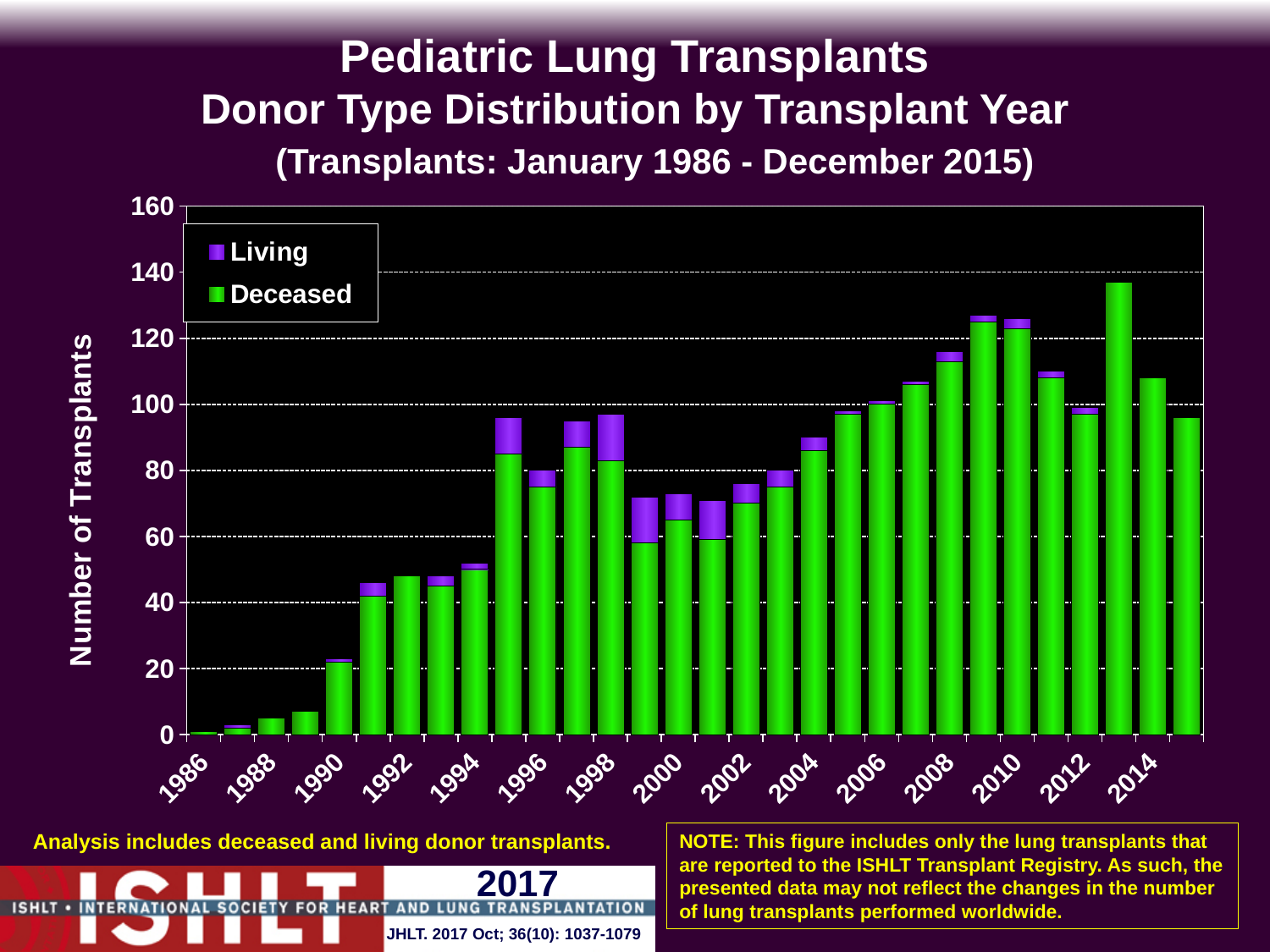
Is the total number of transplants for 2008 greater or less than 100? greater Which year has the lowest total number of transplants? 1986 Is the total number of transplants for 2004 greater or less than 100? less Overall, do the total transplant numbers rise or fall from 1986 to 2014? rise Is the total number of transplants for 1996 greater or less than 100? less Which year has more total transplants, 2000 or 2008? 2008 How many series does the legend list? 2 Which year has the highest total number of transplants? 2013 What are the two donor types listed in the legend? Living and Deceased What kind of chart is shown on the slide? Stacked bar chart Which year has more total transplants, 2014 or 2012? 2014